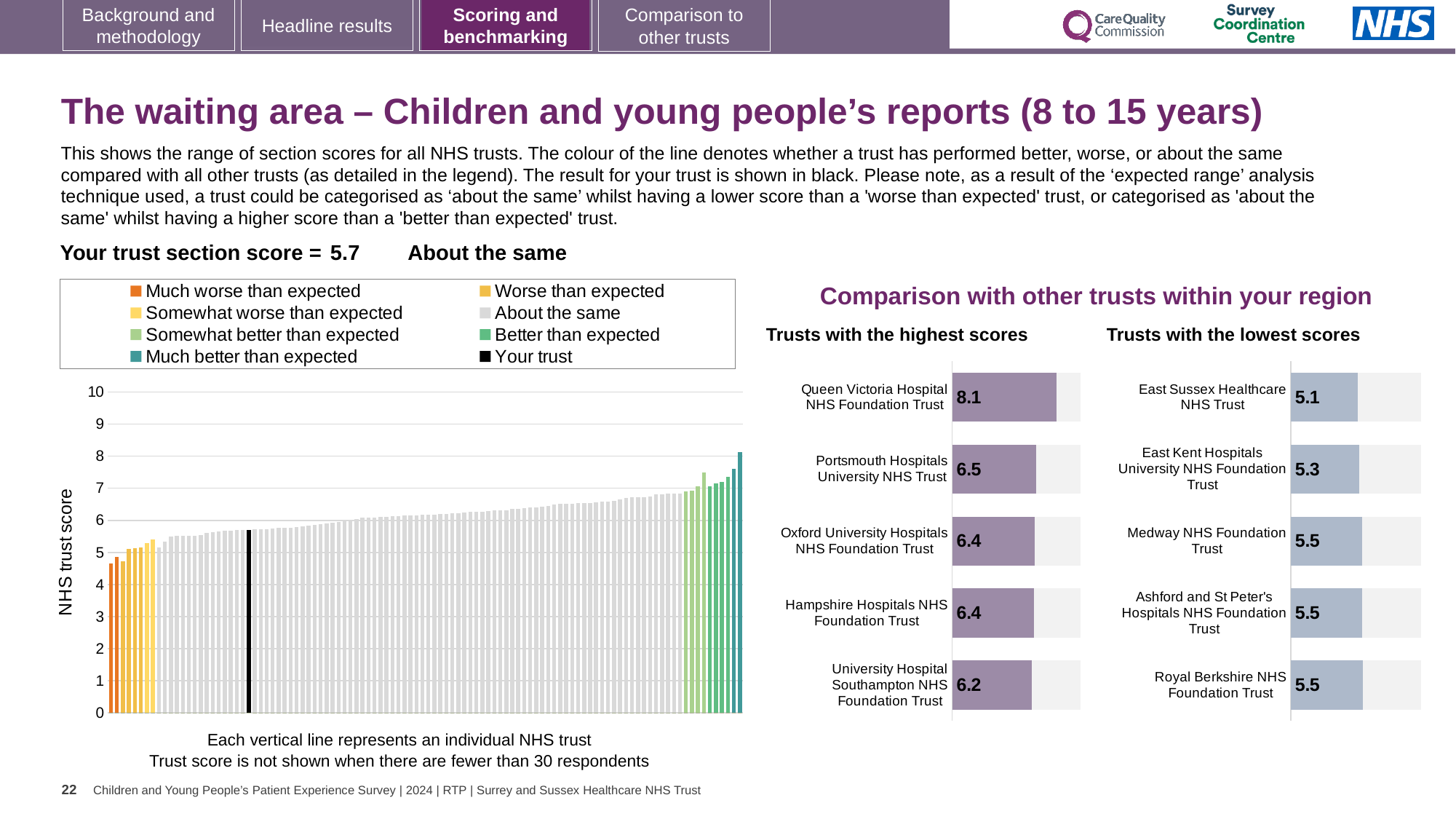
In the 'Trusts with the lowest scores' chart, what is the score for East Kent Hospitals University NHS Foundation Trust? 5.3 In the 'Trusts with the highest scores' chart, what is the difference between the scores of Queen Victoria Hospital NHS Foundation Trust and Portsmouth Hospitals University NHS Trust? 1.6 How many entries does the legend of the NHS trust score chart on the left list? 8 In the 'Trusts with the highest scores' chart, what is the score for Queen Victoria Hospital NHS Foundation Trust? 8.1 How many trusts are listed in the 'Trusts with the lowest scores' chart? 5 In the 'Trusts with the highest scores' chart, which trust has the highest score? Queen Victoria Hospital NHS Foundation Trust In the NHS trust score chart on the left, is the value of the lowest (leftmost) bar greater or less than 5? less In the 'Trusts with the lowest scores' chart, what is the difference between the scores of East Kent Hospitals University NHS Foundation Trust and East Sussex Healthcare NHS Trust? 0.2 In the NHS trust score chart on the left, what is the score for your trust (the black bar)? 5.7 Which is larger: the score for University Hospital Southampton NHS Foundation Trust in the highest scores chart, or the score for Medway NHS Foundation Trust in the lowest scores chart? University Hospital Southampton NHS Foundation Trust In the 'Trusts with the highest scores' chart, what is the score for Portsmouth Hospitals University NHS Trust? 6.5 In the 'Trusts with the lowest scores' chart, which trust has the lowest score? East Sussex Healthcare NHS Trust